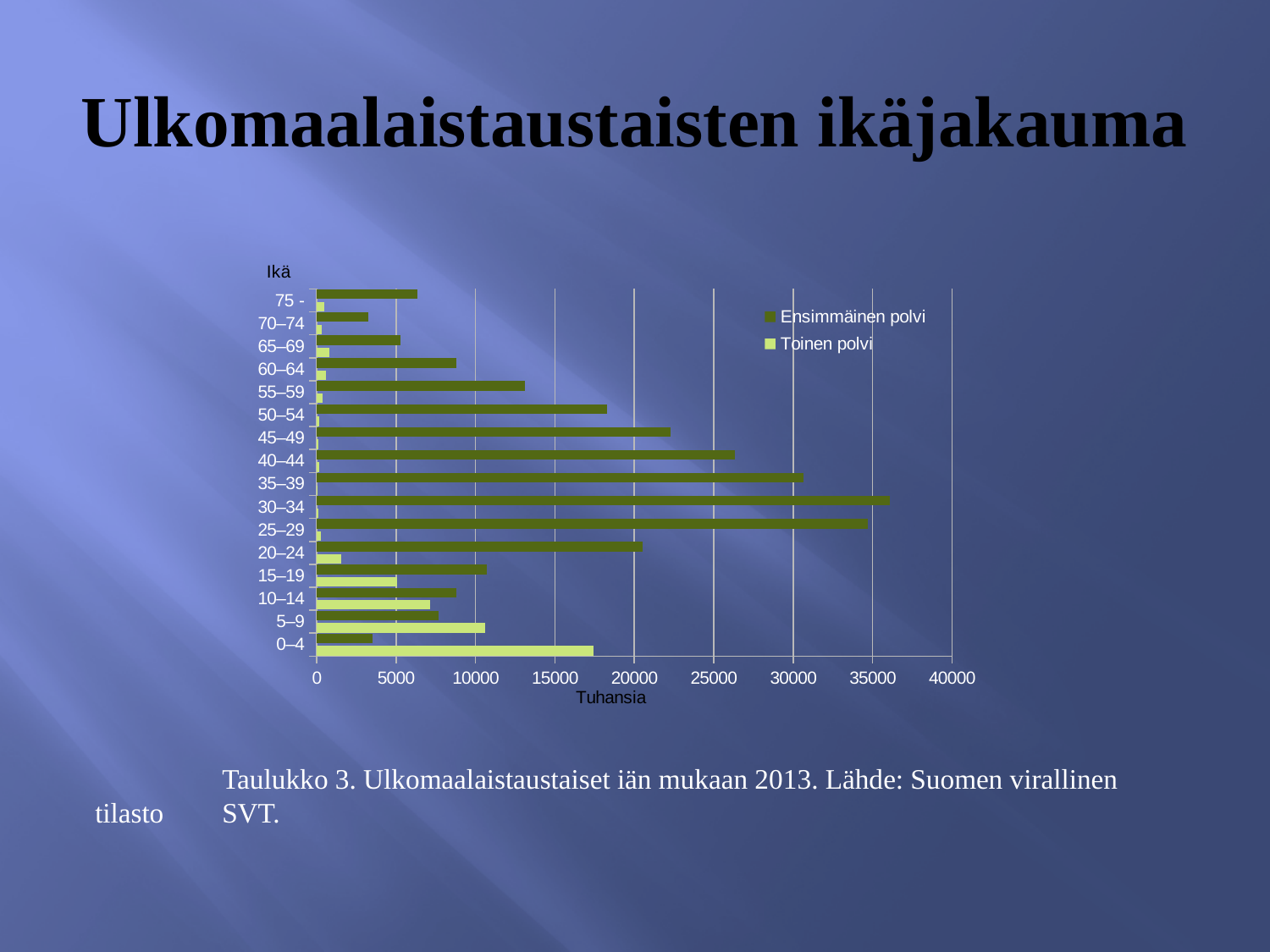
What kind of chart is shown on the slide? bar chart Is the value for Toinen polvi in the 5–9 age group greater or less than 10000? greater How many series does the legend list? 2 Which age group has the highest value for Ensimmäinen polvi? 30–34 Is the value for Ensimmäinen polvi in the 0–4 age group greater or less than 5000? less In the 0–4 age group, which series has the larger value, Ensimmäinen polvi or Toinen polvi? Toinen polvi Which age group has the highest value for Toinen polvi? 0–4 How many age groups are shown on the chart? 16 Is the value for Ensimmäinen polvi in the 30–34 age group greater or less than 35000? greater In the 15–19 age group, which series has the larger value, Ensimmäinen polvi or Toinen polvi? Ensimmäinen polvi What is the label on the horizontal axis of the chart? Tuhansia